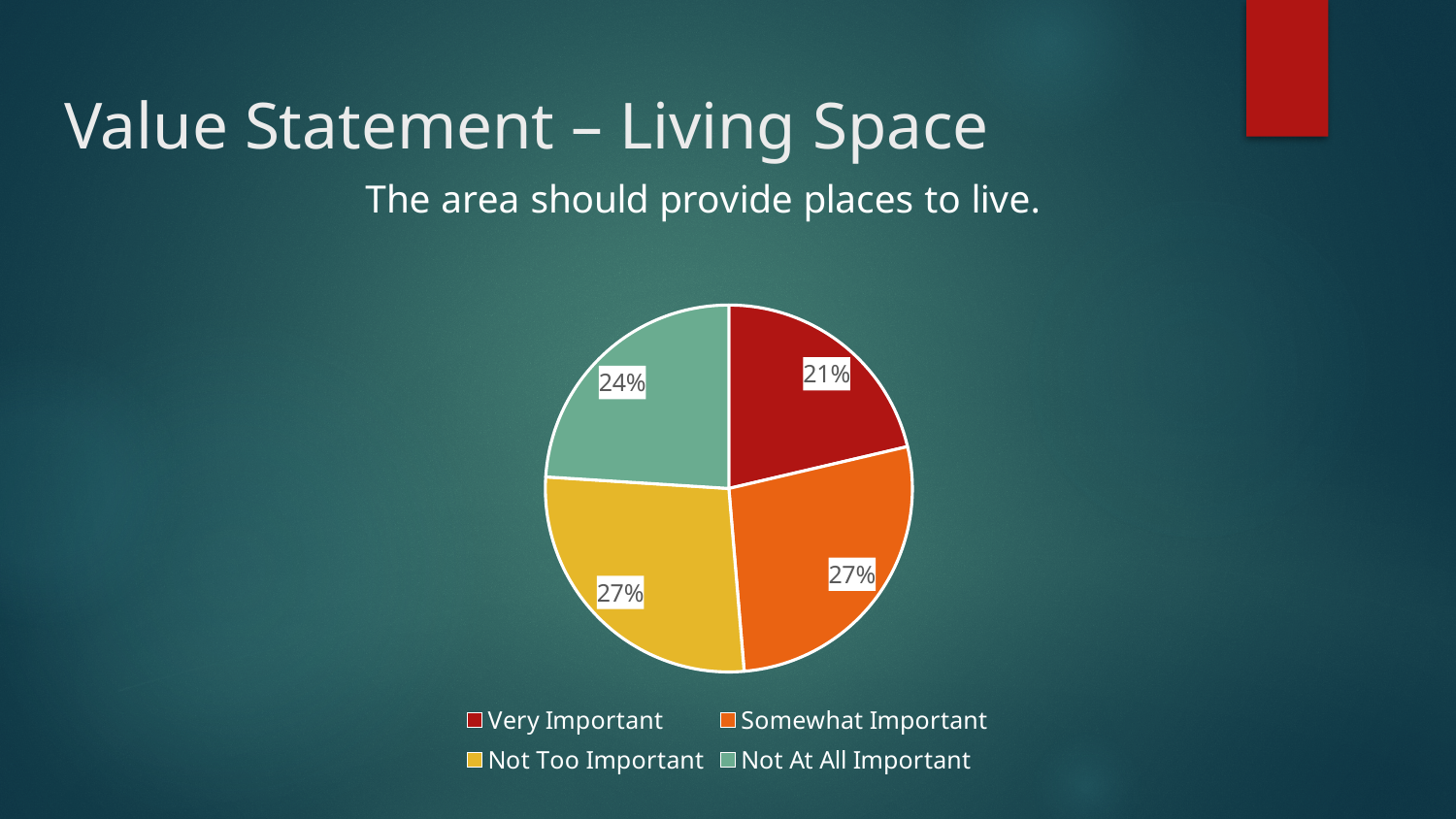
What share of the pie is labelled Somewhat Important? 27% How many entries does the legend list? 4 What kind of chart is shown on the slide? pie chart Which category has the smallest slice of the pie? Very Important What is the difference in percentage points between Somewhat Important and Very Important? 6 Which is larger, the Not At All Important slice or the Very Important slice? Not At All Important What percentage is shown for Not At All Important? 24% What is the difference in percentage points between Not At All Important and Very Important? 3 What percentage of respondents said the living space value statement was Very Important? 21% What percentage is shown for Not Too Important? 27% How many slices does the pie chart have? 4 What colour is the Very Important slice? red